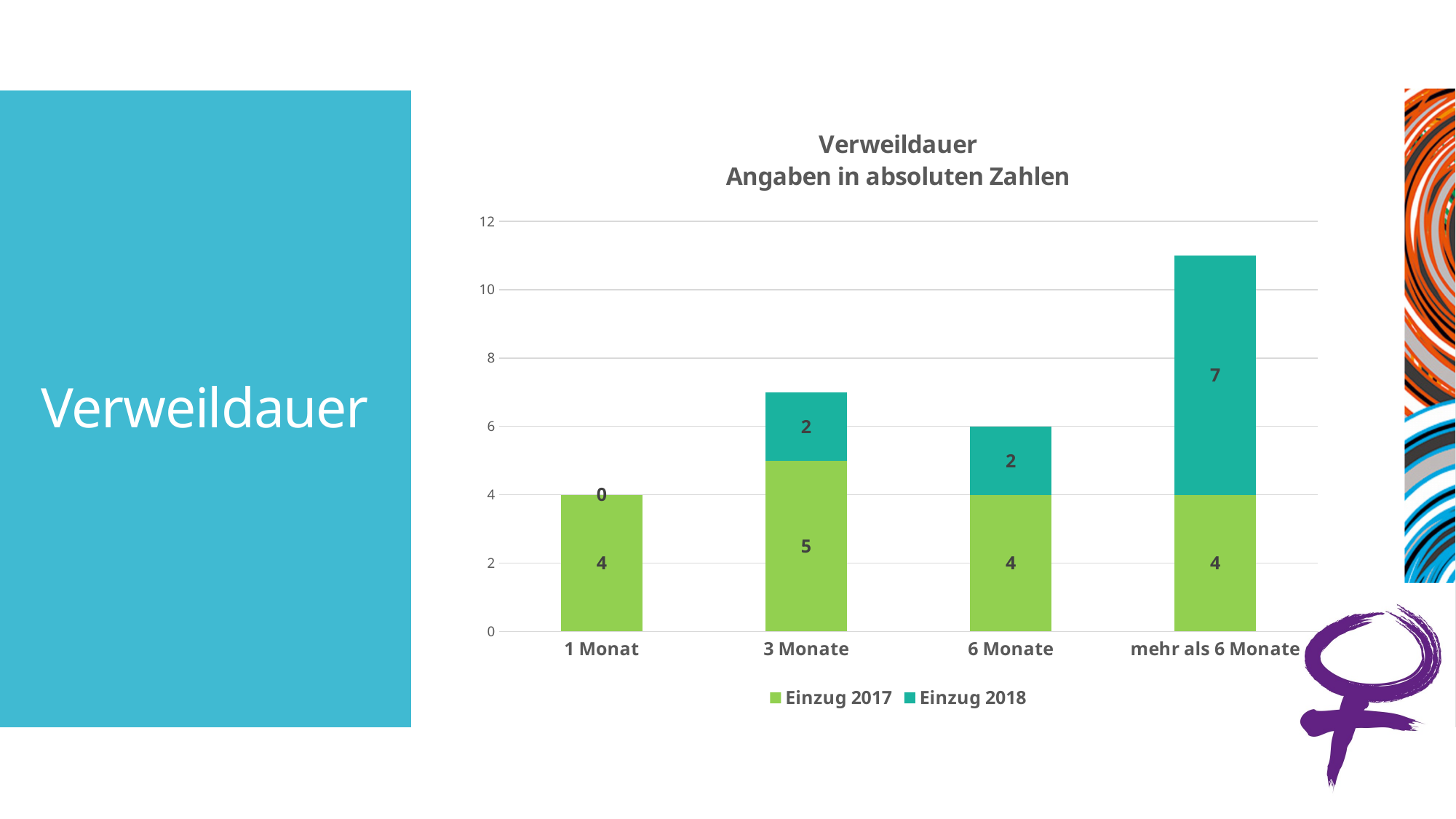
What is the value for Einzug 2017 in the 6 Monate category? 4 What is the difference between Einzug 2018 and Einzug 2017 in the mehr als 6 Monate category? 3 What is the value for Einzug 2018 in the mehr als 6 Monate category? 7 What is the total of the stacked bar for 3 Monate? 7 What is the total of the stacked bar for mehr als 6 Monate? 11 What is the value for Einzug 2018 in the 1 Monat category? 0 How many series does the legend list? 2 Which category has the highest value for Einzug 2018? mehr als 6 Monate Which is larger in the 3 Monate category: Einzug 2017 or Einzug 2018? Einzug 2017 Which category has the lowest value for Einzug 2018? 1 Monat What is the value for Einzug 2017 in the 3 Monate category? 5 How many categories are shown on the x axis? 4